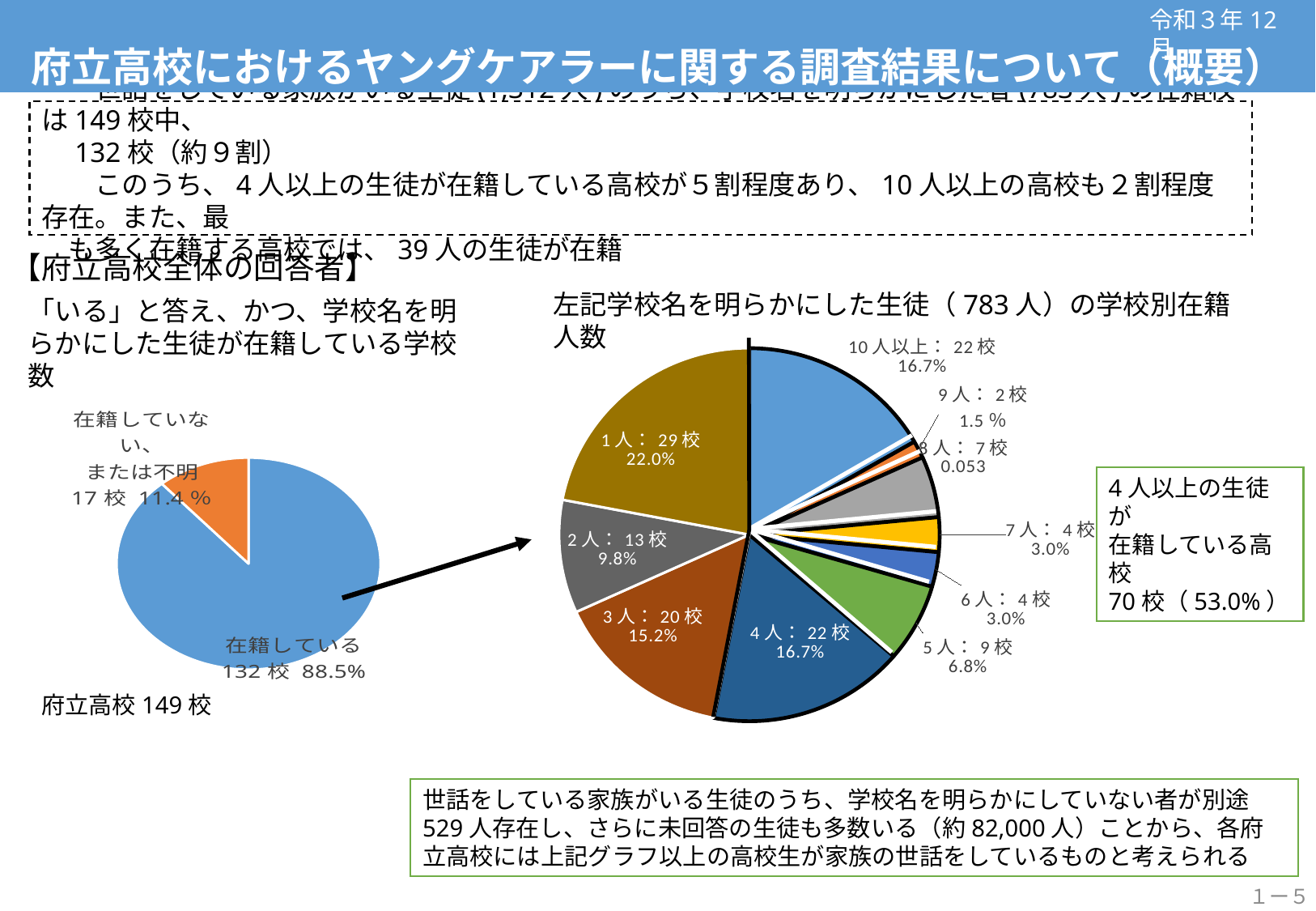
In the right pie chart (学校別在籍人数), what is the difference in number of schools between the 1人 slice and the 2人 slice? 16校 In the right pie chart (学校別在籍人数), how many slices are there? 10 In the right pie chart (学校別在籍人数), how many schools are in the 1人 slice? 29校 In the right pie chart (学校別在籍人数), what percentage share does the 3人 slice have? 15.2% What type of chart is the left chart (府立高校149校)? pie chart In the right pie chart (学校別在籍人数), which category has the fewest schools? 9人 In the right pie chart (学校別在籍人数), what percentage share does the 10人以上 slice have? 16.7% In the left pie chart (府立高校149校), how many slices are there? 2 In the right pie chart (学校別在籍人数), which category has the largest share? 1人 In the left pie chart (府立高校149校), what percentage share does the 在籍していない、または不明 slice have? 11.4% In the right pie chart (学校別在籍人数), which has more schools, 5人 or 6人? 5人 In the left pie chart (府立高校149校), how many schools are in the 在籍している slice? 132校